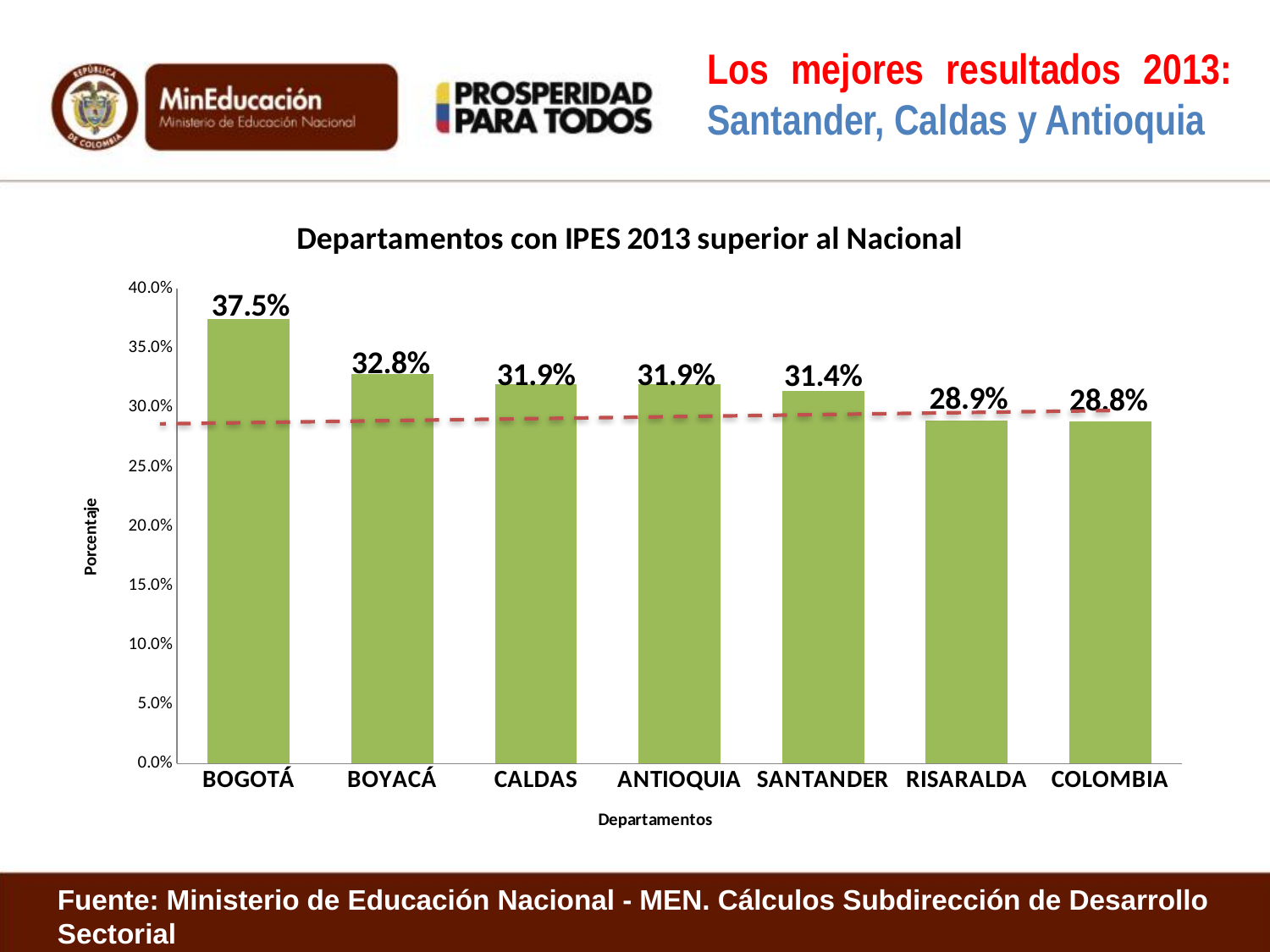
Is the value for CALDAS greater or less than 30.0%? greater Which category has the lowest value? COLOMBIA What is the value for SANTANDER? 31.4% How many categories are shown on the x axis? 7 Do the bar values rise or fall from left to right along the x axis? fall Which department has the highest value? BOGOTÁ What is the value for BOGOTÁ? 37.5% What is the title of the chart? Departamentos con IPES 2013 superior al Nacional What is the difference between the values for BOGOTÁ and BOYACÁ? 4.7% Which is larger, the value for BOYACÁ or the value for RISARALDA? BOYACÁ What kind of chart is this? bar chart What is the value for COLOMBIA? 28.8%